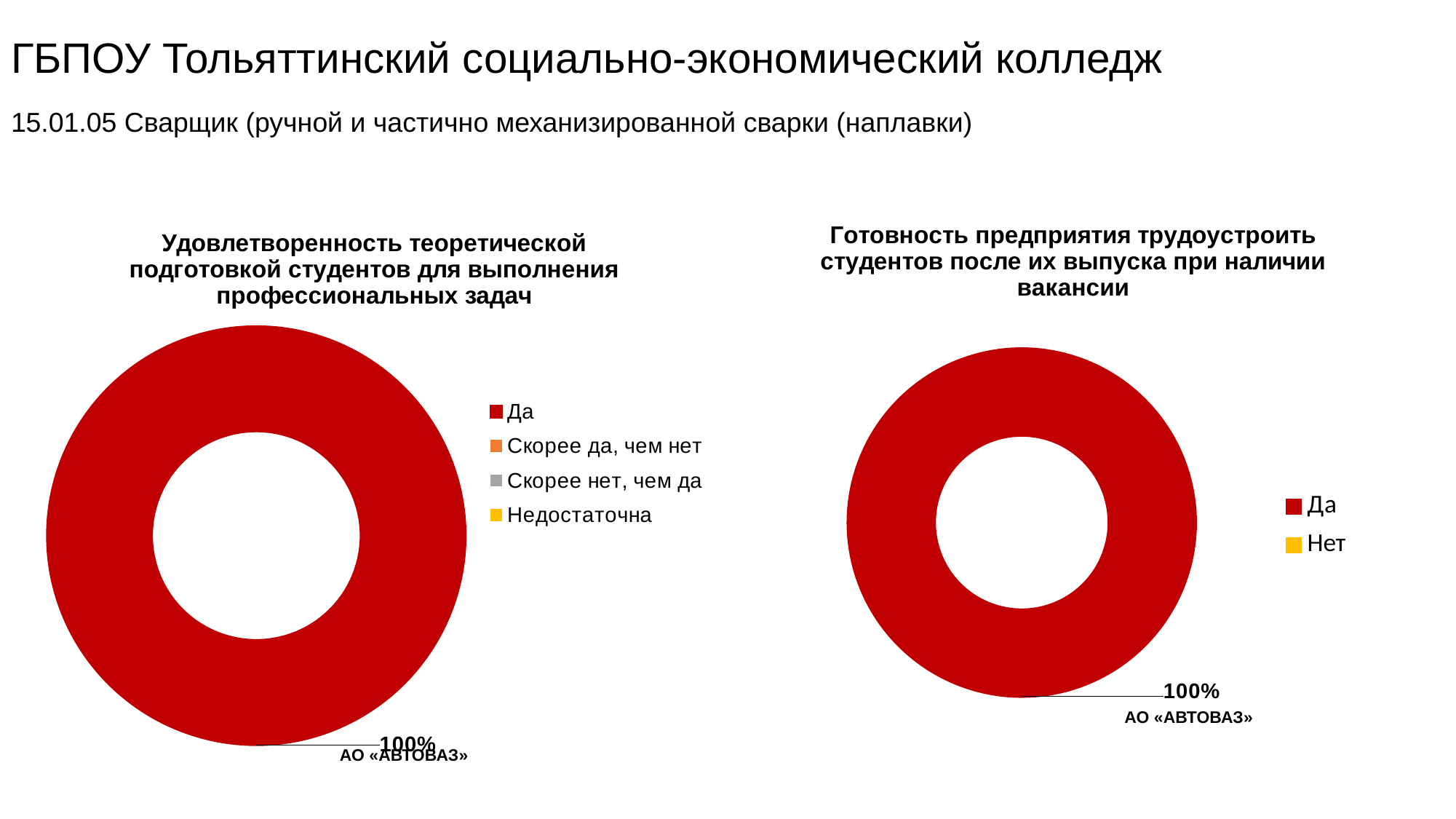
What colour represents "Нет" in the legend of the right chart? Yellow How many entries does the legend of the left chart list? 4 In the left chart, which category has the largest share? Да What kind of chart is the left chart titled "Удовлетворенность теоретической подготовкой студентов для выполнения профессиональных задач"? Doughnut (pie) chart Which enterprise is named in the data label of the right chart? АО «АВТОВАЗ» In the right chart, what is the value labelled for "Да"? 100% How many entries does the legend of the right chart list? 2 In the left chart, what share of the doughnut does the "Да" slice take? 100% In the right chart, what share of the doughnut does the "Да" slice take? 100% In the left chart, what is the value labelled for "Да"? 100% What kind of chart is the right chart titled "Готовность предприятия трудоустроить студентов после их выпуска при наличии вакансии"? Doughnut (pie) chart In the right chart, which category has the largest share? Да